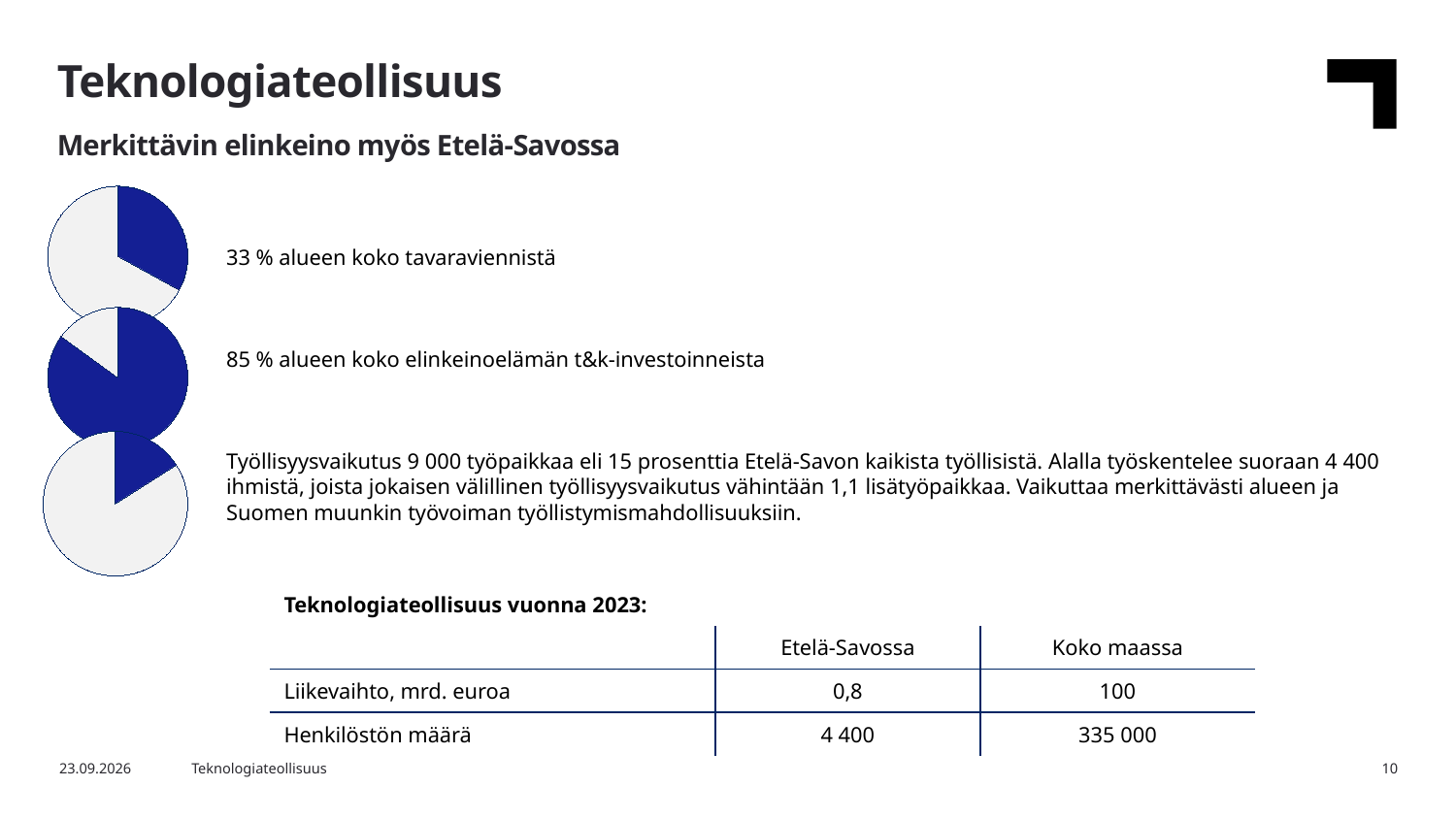
Which of the three pie charts has the largest blue slice? The middle one (85 %) What kind of charts are shown on the left side of the slide? Pie charts Is the blue slice in the top pie chart greater or less than 50 % of the pie? less Which of the three pie charts has the smallest blue slice? The bottom one (15 prosenttia) Is the blue slice in the top pie chart larger or smaller than the blue slice in the bottom pie chart? Larger How many pie charts are on the slide? 3 In the bottom pie chart, what share of all employed people in Etelä-Savo does the blue slice represent? 15 prosenttia In the middle pie chart, what share of the region's business R&D investments does the blue slice represent? 85 % What colour is used for the highlighted slice in each pie chart? Dark blue Is the blue slice in the middle pie chart greater or less than 50 % of the pie? greater In the top pie chart, what share of the region's total goods exports does the blue slice represent? 33 % What is the difference in percentage points between the blue slice of the middle pie chart and the blue slice of the top pie chart? 52 percentage points